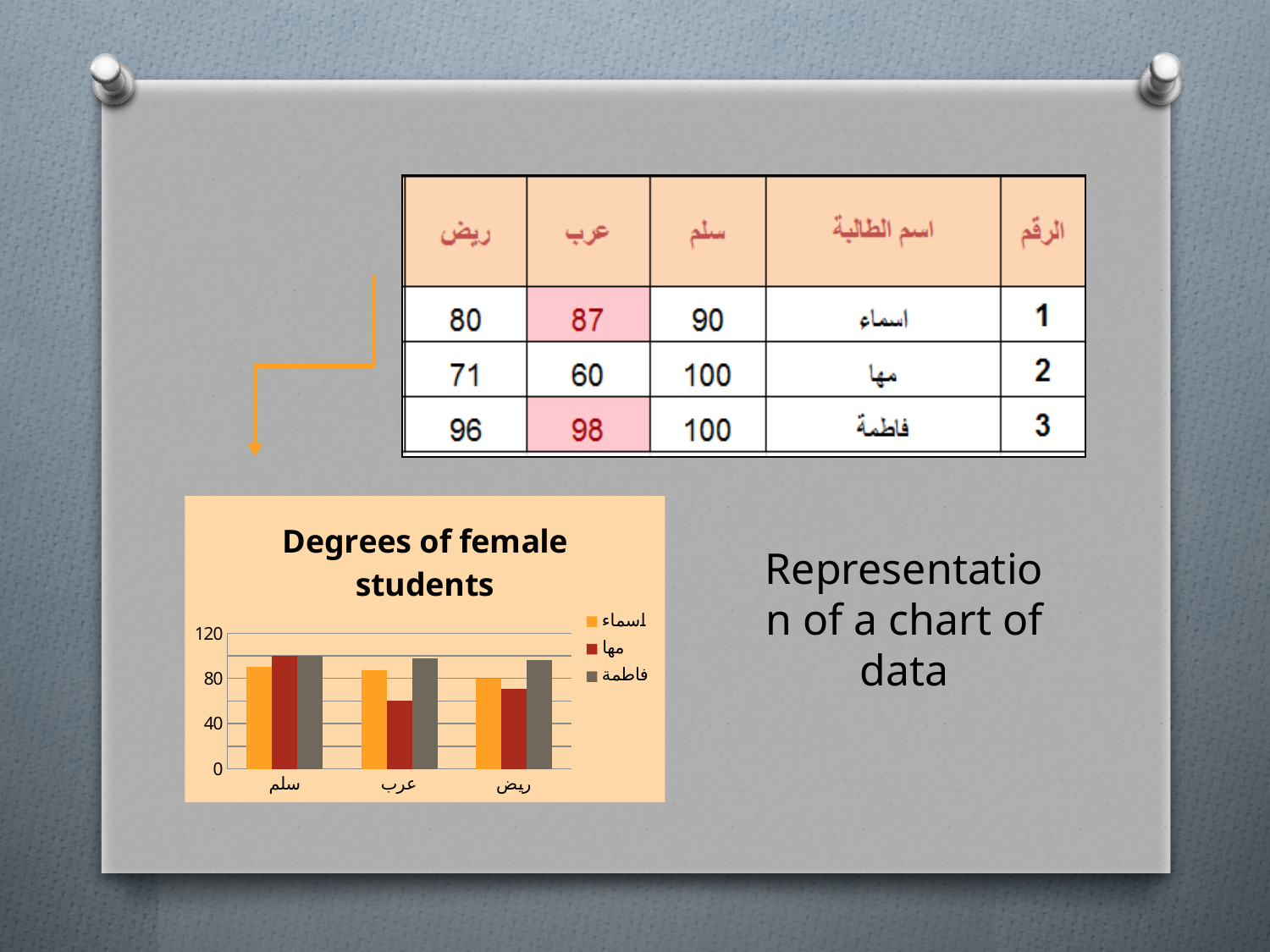
What kind of chart is shown on the slide? bar chart How many series does the chart legend list? 3 Which series has the highest value in the عرب category? فاطمة Is the value for فاطمة in the ريض category greater or less than 80? greater Is the value for اسماء in the سلم category greater or less than 80? greater Which series has the lowest value in the ريض category? مها Is the value for مها in the عرب category greater or less than 80? less How many categories are shown on the x axis of the chart? 3 Which is larger: the value for مها in عرب or the value for مها in ريض? ريض What is the value for اسماء in the ريض category? 80 What colour are the bars for the اسماء series? orange What is the title of the chart? Degrees of female students